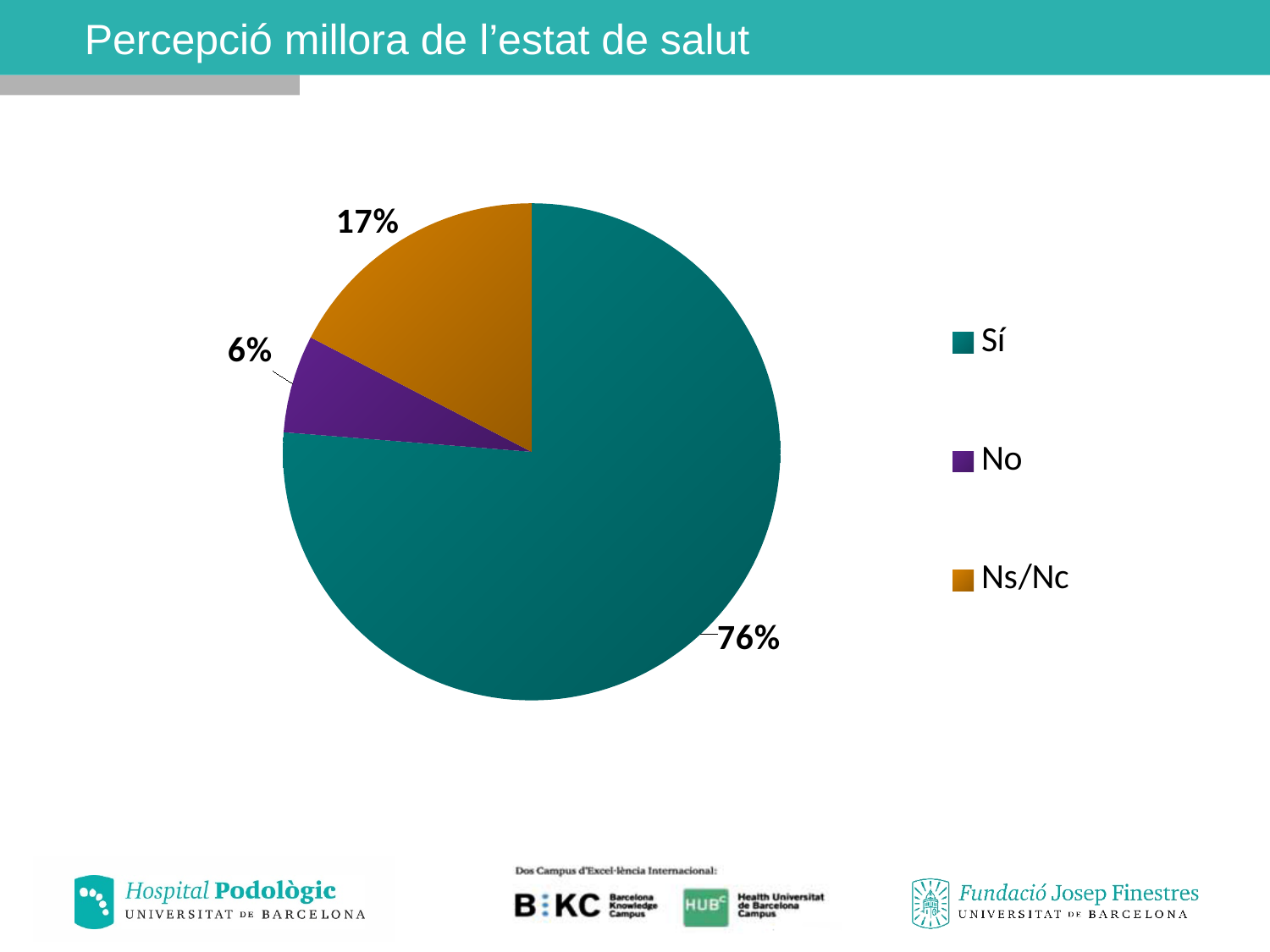
What percentage of the pie chart corresponds to 'No'? 6% What percentage of the pie chart corresponds to 'Sí'? 76% What percentage of the pie chart corresponds to 'Ns/Nc'? 17% Which category has the smallest slice of the pie chart? No What is the difference in percentage points between the 'Sí' slice and the 'Ns/Nc' slice? 59 What is the title of the slide containing the chart? Percepció millora de l'estat de salut Which category has the largest slice of the pie chart? Sí What is the difference in percentage points between the 'Ns/Nc' slice and the 'No' slice? 11 Which slice is larger, 'No' or 'Ns/Nc'? Ns/Nc What colour is the 'Ns/Nc' slice in the pie chart? Orange What type of chart is shown on the slide? Pie chart How many categories are shown in the pie chart? 3